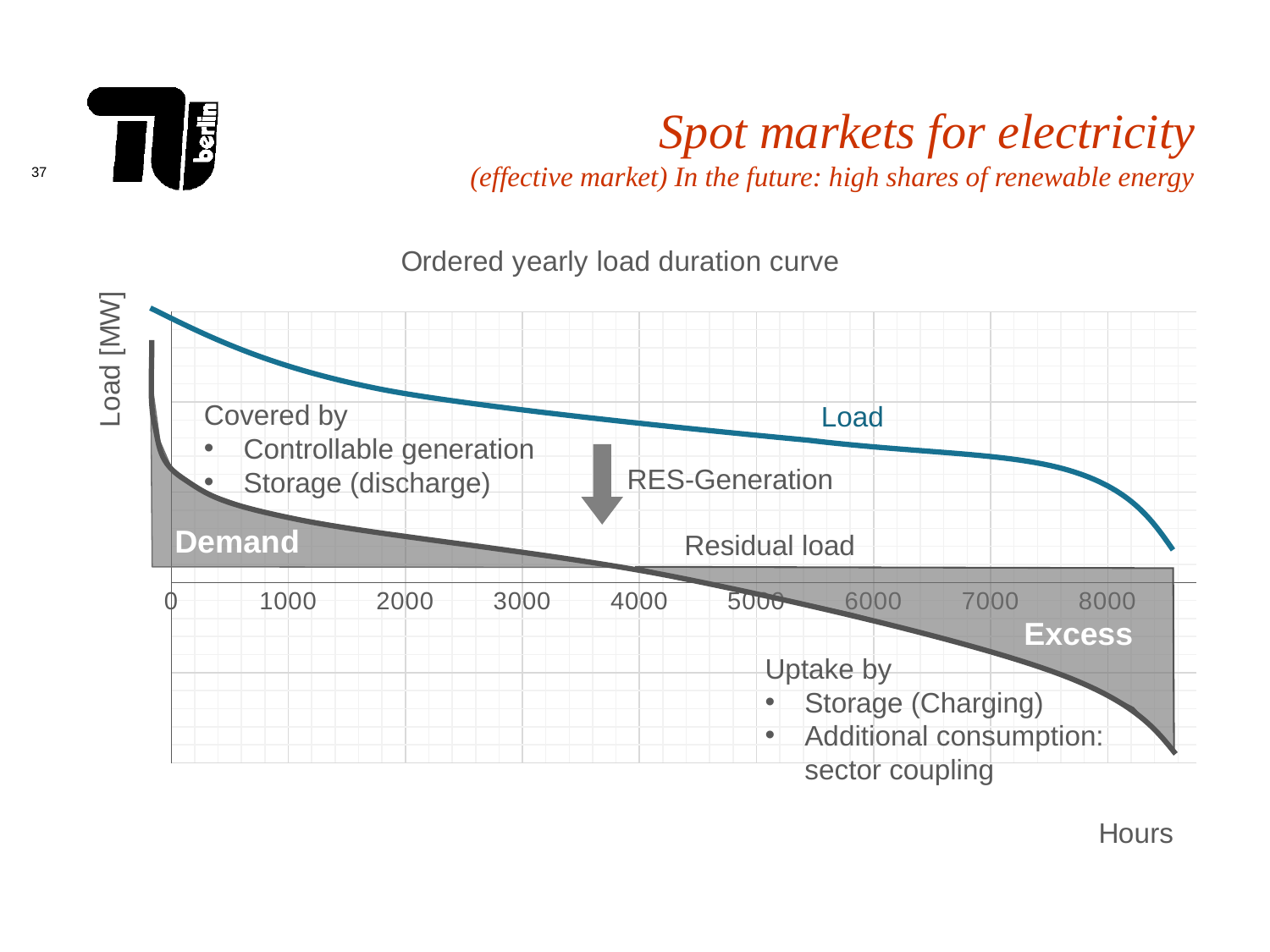
What is the title of the chart? Ordered yearly load duration curve How many curves are plotted on the chart? 2 Does the Load curve rise or fall as hours increase from 0 to 8000? fall At 6000 hours, which curve has the larger value, Load or Residual load? Load How many labelled tick values are shown on the x axis? 9 What is the label of the y axis of the chart? Load [MW] What is the largest tick value shown on the x axis? 8000 At 2000 hours, which curve is higher, Load or Residual load? Load Which curve has the highest value at 0 hours? Load Does the Residual load curve rise or fall along the x axis? fall What kind of chart is shown on the slide? line chart Which curve reaches the lowest value on the chart? Residual load